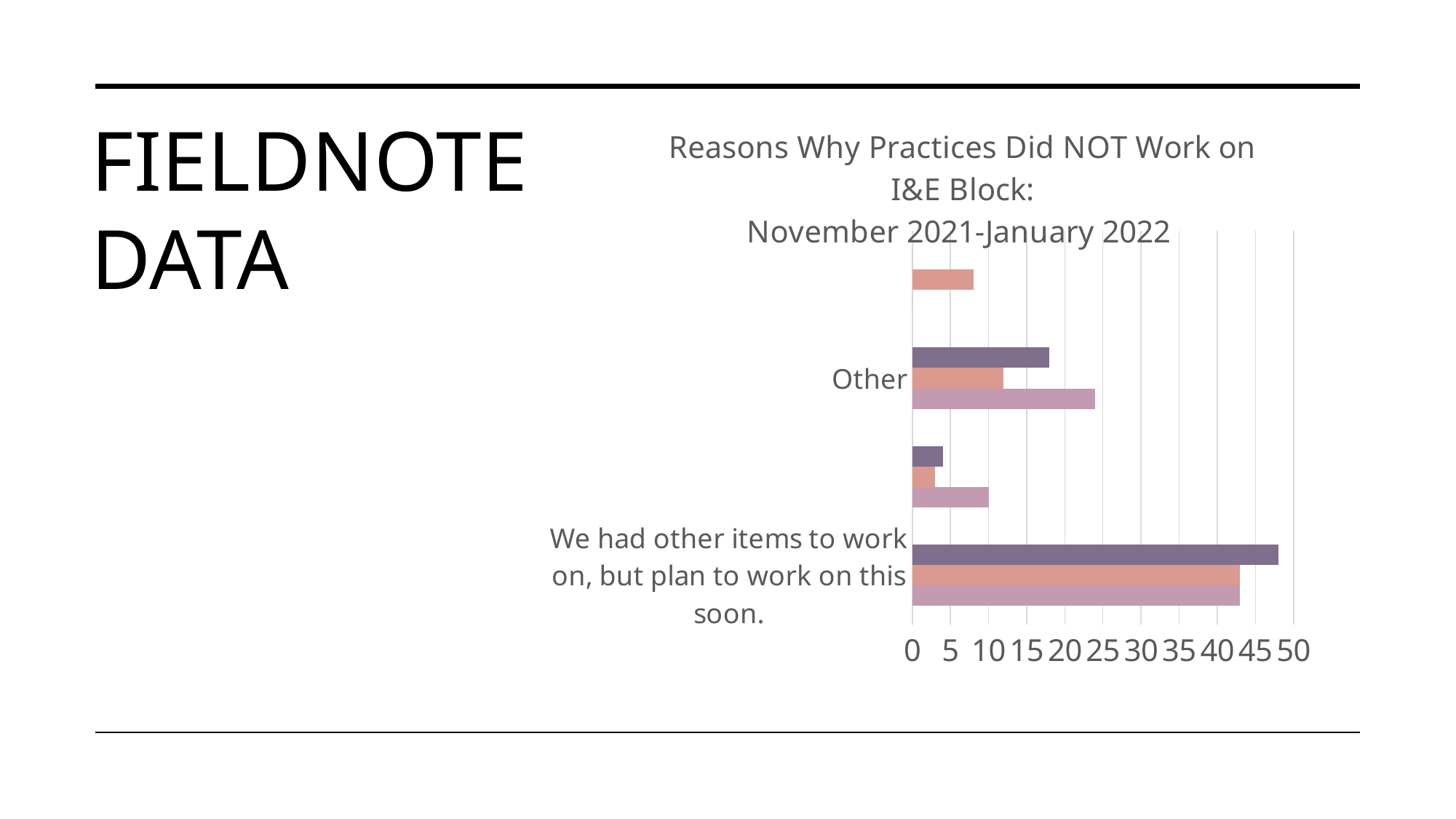
What kind of chart is shown on the slide? Bar chart For the "Other" category, which bar is longer: the salmon bar or the dark purple bar? The dark purple bar What is the highest value shown on the horizontal axis? 50 Is the value of the salmon bar for "Other" greater or less than 15? less For the "Other" category, which bar is longer: the dark purple bar or the light mauve bar? The light mauve bar Is the value of the dark purple bar for "We had other items to work on, but plan to work on this soon." greater or less than 45? greater Is the value of the salmon bar for "We had other items to work on, but plan to work on this soon." greater or less than 40? greater Which category has the longest bars in the chart? We had other items to work on, but plan to work on this soon. What is the title of the chart? Reasons Why Practices Did NOT Work on I&E Block: November 2021-January 2022 How many category groups of bars are plotted in the chart? 4